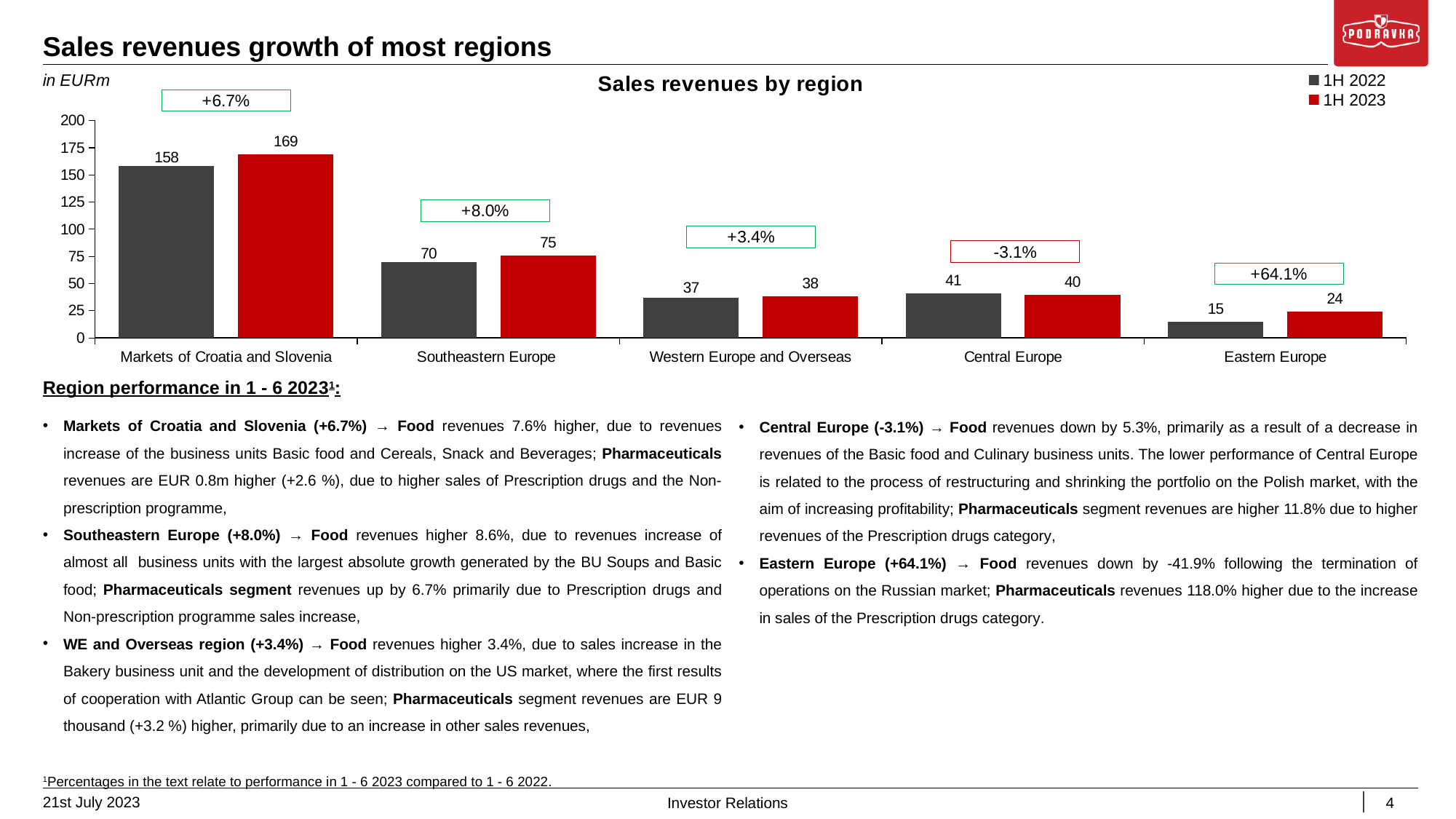
What is the 1H 2023 sales revenue for Eastern Europe? 24 What growth percentage is shown above the bars for Eastern Europe? +64.1% Which is larger for Central Europe, the 1H 2022 or the 1H 2023 sales revenue? 1H 2022 What is the 1H 2023 sales revenue for Southeastern Europe? 75 How many regions are shown on the x axis of the chart? 5 Is the 1H 2022 value for Western Europe and Overseas greater or less than 50? less What is the difference between the 1H 2023 and 1H 2022 sales revenues for Markets of Croatia and Slovenia? 11 What kind of chart is shown on the slide? bar chart Which region has the highest 1H 2023 sales revenue? Markets of Croatia and Slovenia How many series does the legend list? 2 Which region has the lowest 1H 2022 sales revenue? Eastern Europe What is the 1H 2022 sales revenue for Central Europe? 41